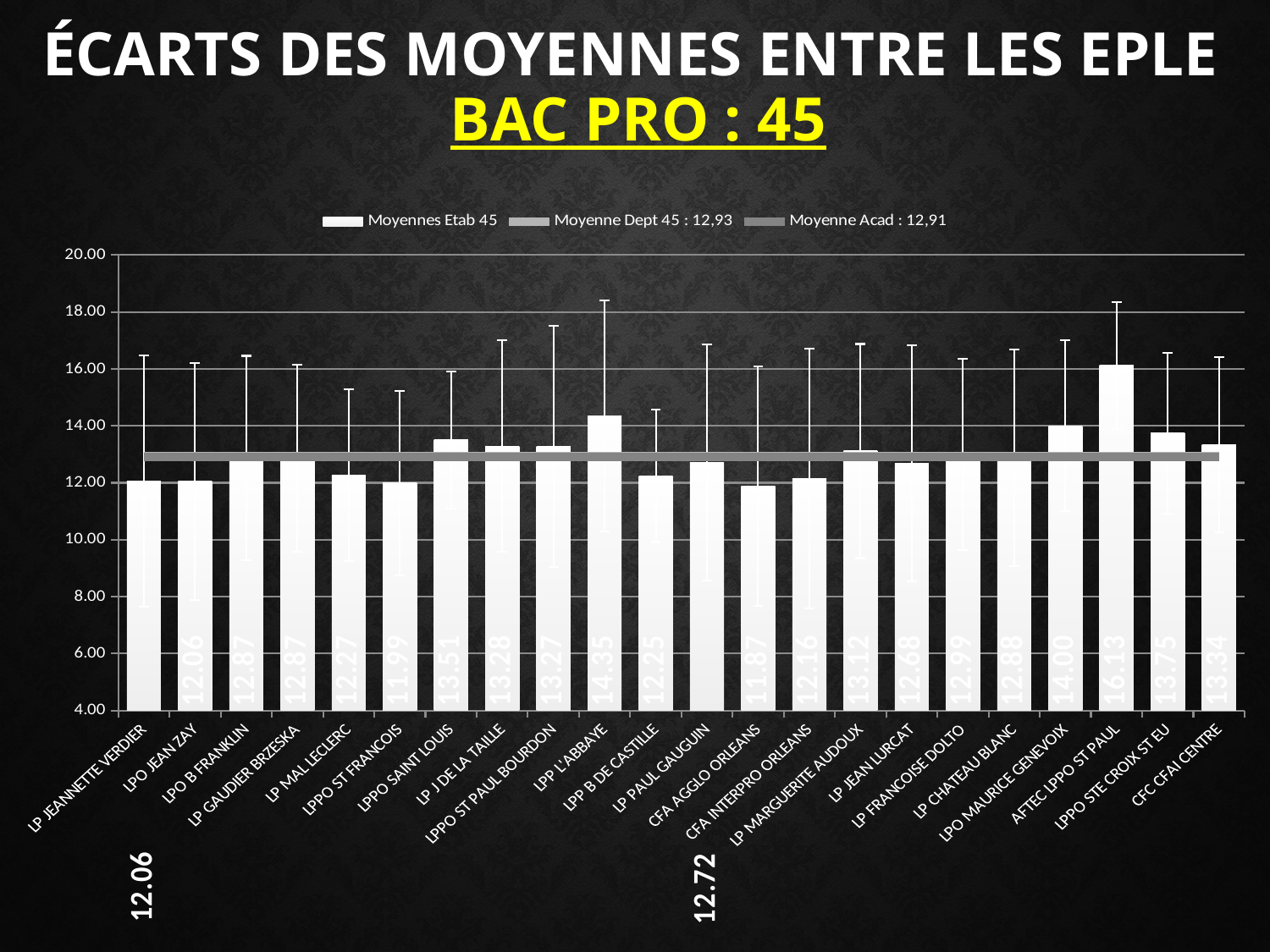
How many establishments are shown on the x axis? 22 What is the difference between the values for AFTEC LPPO ST PAUL and LPP L'ABBAYE? 1.78 What kind of chart is shown on the slide? combination bar and line chart Which is larger, the value for LPPO SAINT LOUIS or the value for CFC CFAI CENTRE? LPPO SAINT LOUIS What is the value for LPO MAURICE GENEVOIX? 14.00 Which establishment has the lowest value? CFA AGGLO ORLEANS What is the value for CFA AGGLO ORLEANS? 11.87 What is the value for LPP L'ABBAYE? 14.35 What is the value for AFTEC LPPO ST PAUL? 16.13 How many series does the legend list? 3 Which establishment has the highest value? AFTEC LPPO ST PAUL Is the value for AFTEC LPPO ST PAUL greater or less than 16.00? greater